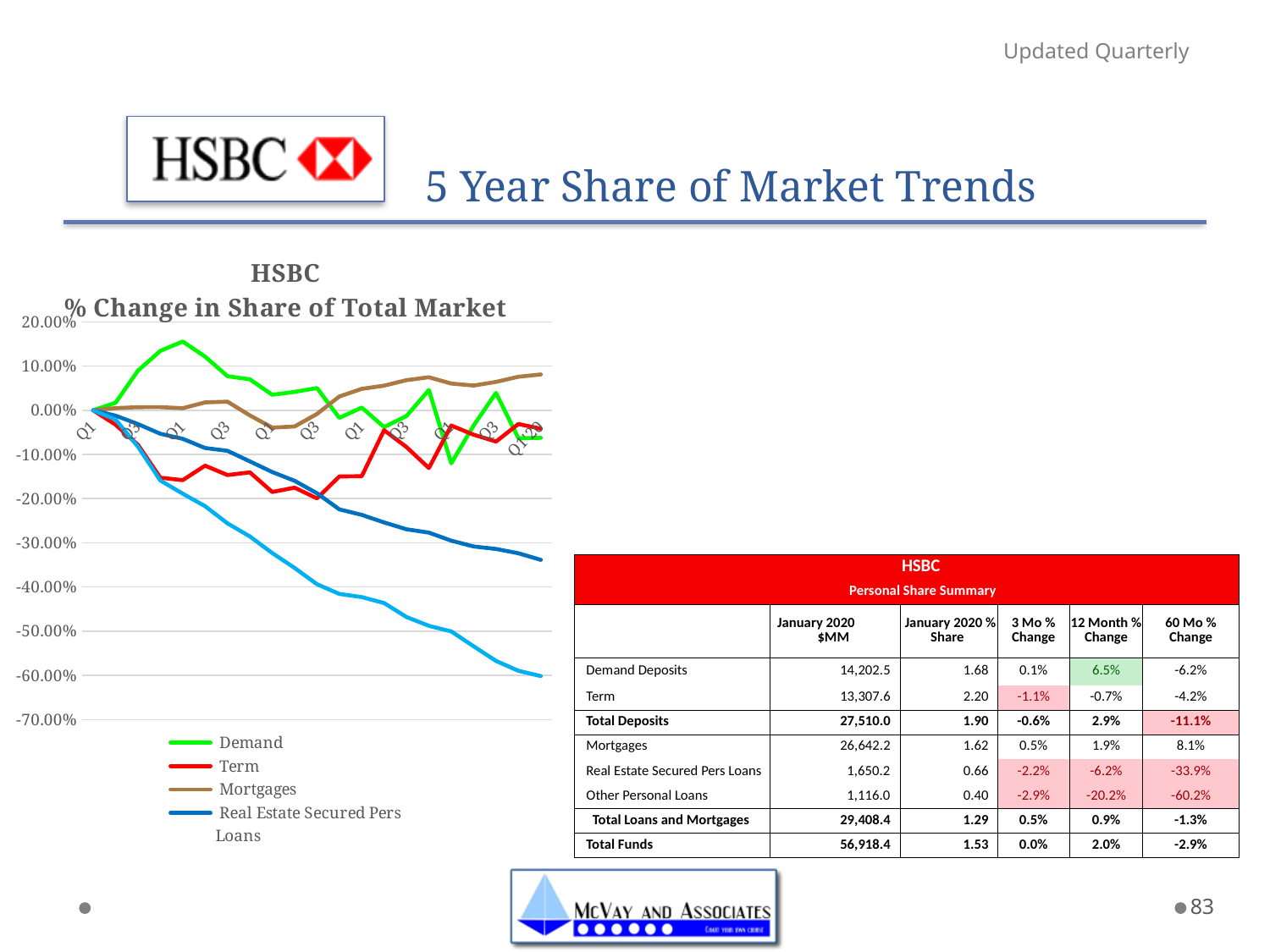
What colour is the Demand line in the chart? green What is the highest value shown on the chart's vertical axis? 20.00% At the right end of the chart, is the value for Real Estate Secured Pers Loans greater or less than -30.00%? less At the right end of the chart, is the value for Mortgages greater or less than 0.00%? greater At the right end of the chart, is the value for Term greater or less than -10.00%? greater What kind of chart is shown on the slide? line chart Which series has the highest value at the right end of the chart? Mortgages What is the title of the chart on the slide? HSBC % Change in Share of Total Market Does the Real Estate Secured Pers Loans line rise or fall along the x axis? fall Does the Mortgages line rise or fall overall from the start to the end of the x axis? rise At the right end of the chart, which is larger: the Mortgages value or the Real Estate Secured Pers Loans value? Mortgages